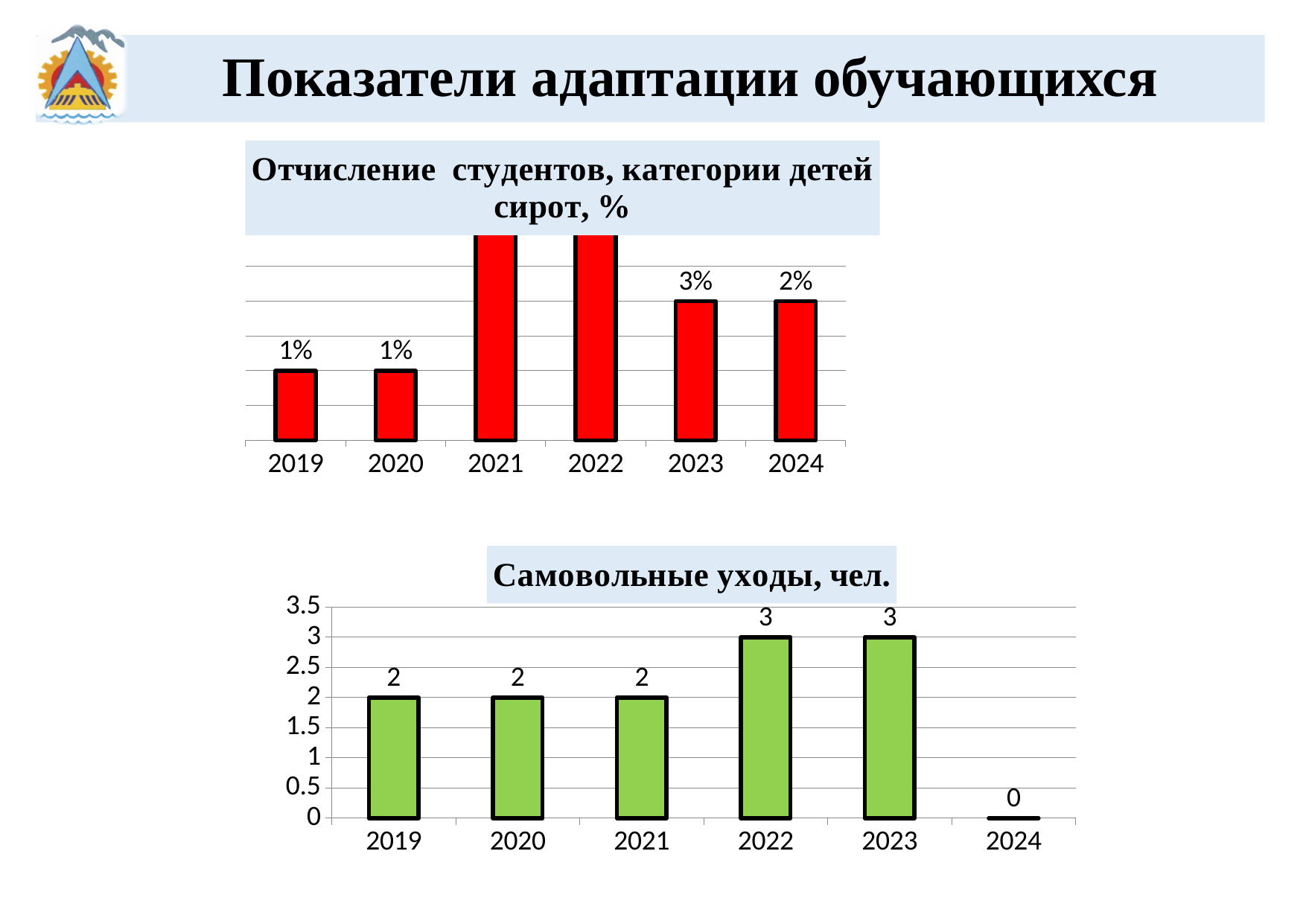
In the chart 'Самовольные уходы, чел.', which year has the lowest value? 2024 How many years are shown on the x axis of the chart 'Отчисление студентов, категории детей сирот, %'? 6 In the chart 'Самовольные уходы, чел.', is the value for 2022 greater or less than 2.5? greater In the chart 'Самовольные уходы, чел.', what is the difference between the values for 2023 and 2021? 1 In the chart 'Отчисление студентов, категории детей сирот, %', what is the value for 2019? 1% In the chart 'Отчисление студентов, категории детей сирот, %', what is the value for 2024? 2% In the chart 'Отчисление студентов, категории детей сирот, %', which is larger, the value for 2023 or for 2024? 2023 In the chart 'Отчисление студентов, категории детей сирот, %', what is the difference between the values for 2023 and 2024? 1% In the chart 'Отчисление студентов, категории детей сирот, %', what is the value for 2023? 3% In the chart 'Самовольные уходы, чел.', what is the value for 2024? 0 What kind of chart is 'Самовольные уходы, чел.'? bar chart In the chart 'Самовольные уходы, чел.', what is the value for 2022? 3